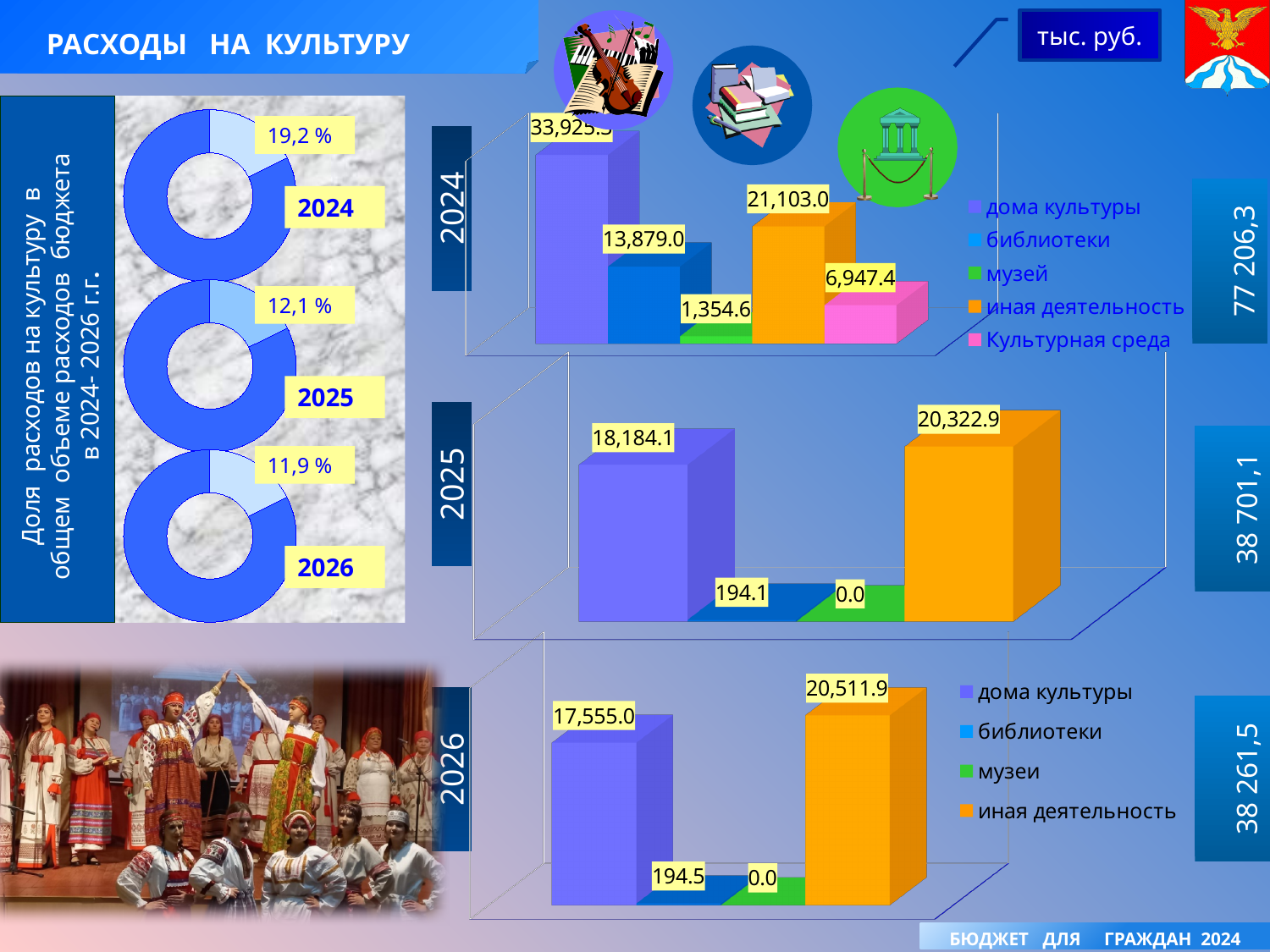
In the donut chart for 2025, what share of the budget do culture expenditures make up? 12,1 % In the 2026 bar chart, what is the value for библиотеки? 194.5 In the 2026 bar chart, which is larger: дома культуры or иная деятельность? иная деятельность How many entries does the legend of the 2024 bar chart list? 5 In the 2025 bar chart, what is the value for дома культуры? 18,184.1 In the 2024 bar chart, what is the value for иная деятельность? 21,103.0 In the 2024 bar chart, what is the value for Культурная среда? 6,947.4 What kind of chart is used to show the 2026 expenditure by category? bar chart In the 2024 bar chart, which category has the highest value? дома культуры In the 2024 bar chart, which category has the lowest value? музей In the 2024 bar chart, what is the value for библиотеки? 13,879.0 In the 2025 bar chart, what is the difference between иная деятельность and дома культуры? 2,138.8